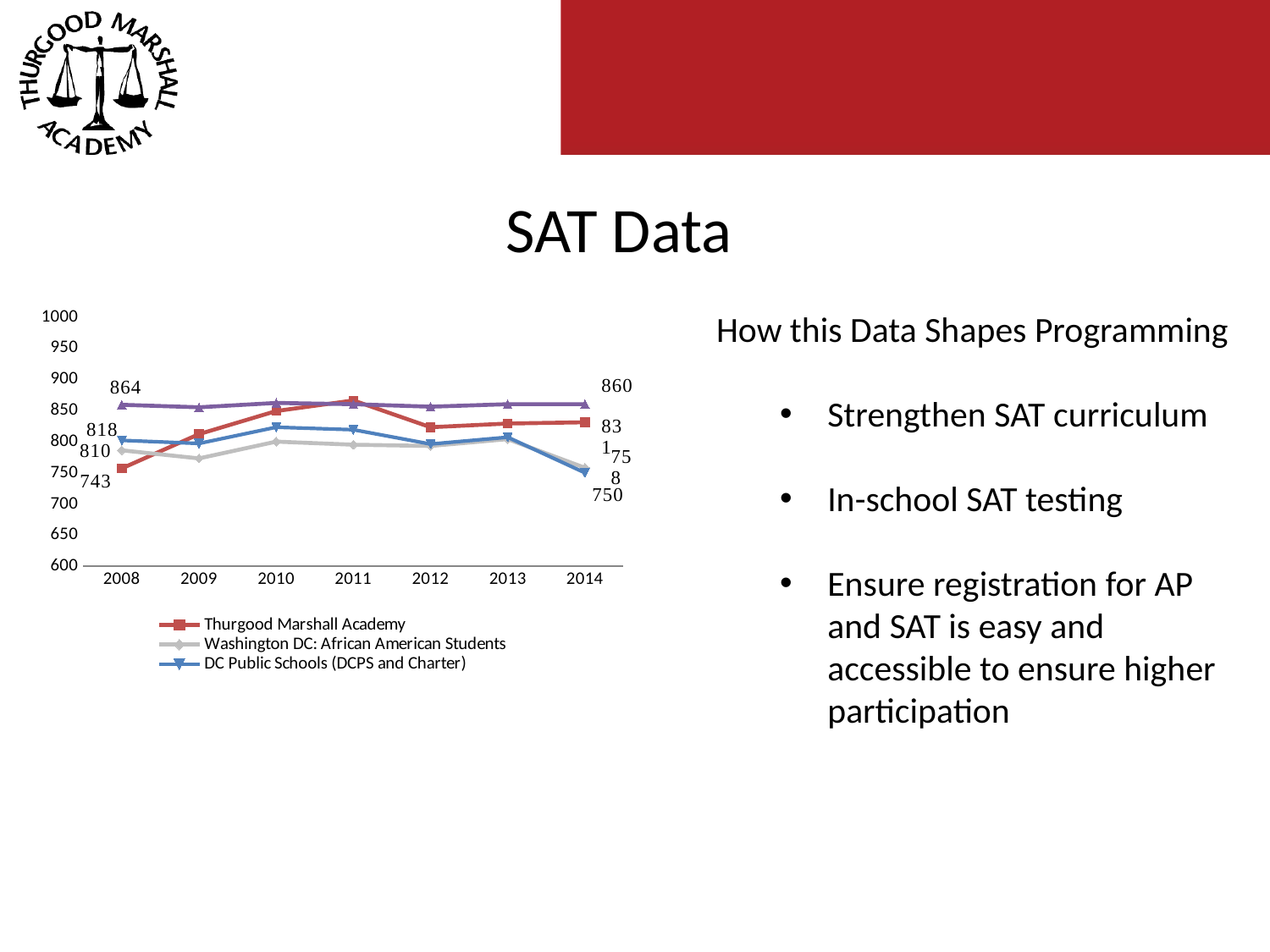
How many series does the chart legend list? 3 In which year is the Thurgood Marshall Academy value lowest? 2008 Is the value for Thurgood Marshall Academy in 2011 greater or less than 850? greater In 2008, which is higher: Thurgood Marshall Academy or DC Public Schools (DCPS and Charter)? DC Public Schools (DCPS and Charter) Does the Thurgood Marshall Academy line rise or fall overall from 2008 to 2014? rise What is the value for Washington DC: African American Students in 2014? 758 What kind of chart is shown on the slide? line chart How many years are shown on the x axis of the chart? 7